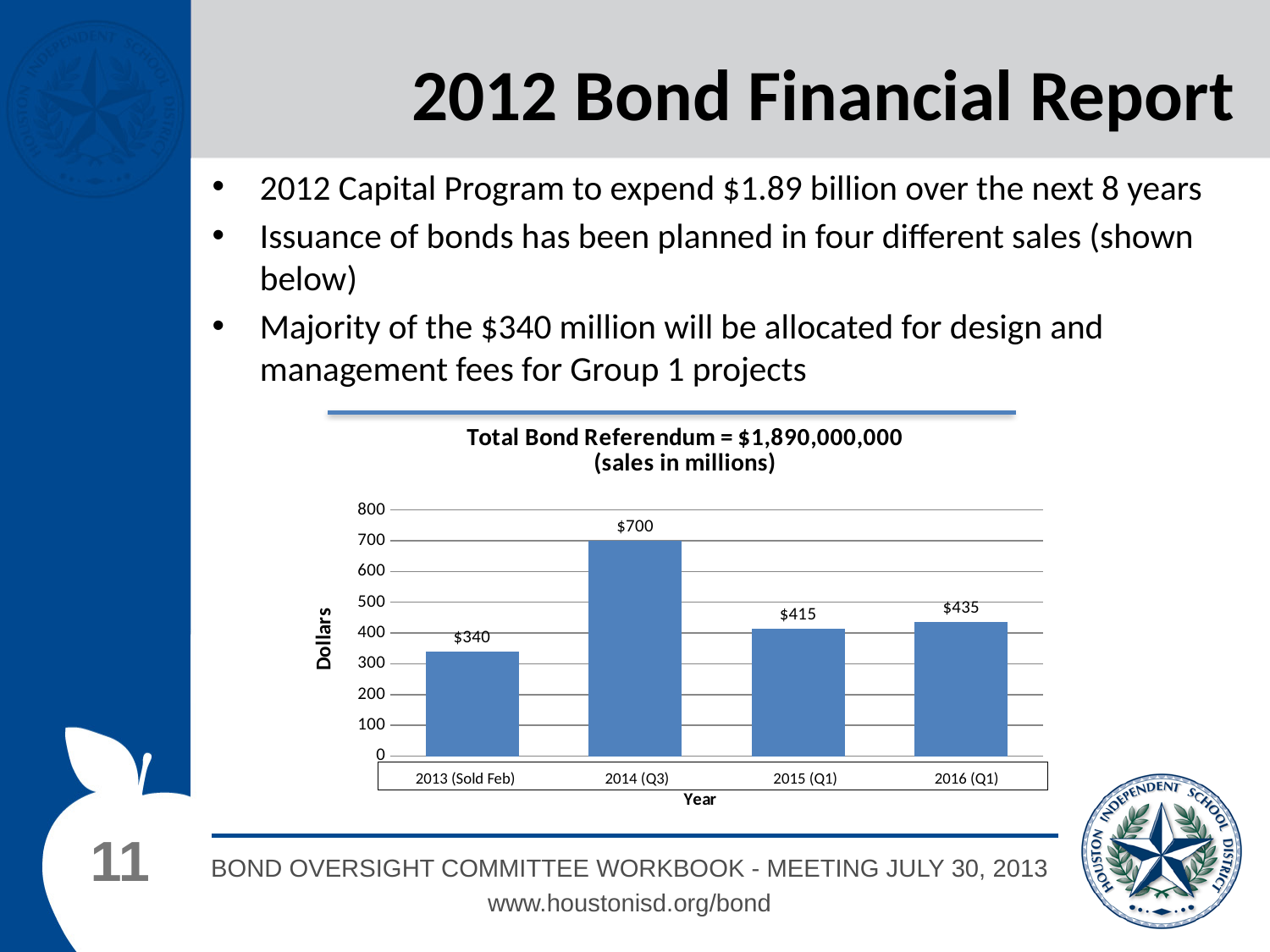
What is the difference between the values for 2014 (Q3) and 2013 (Sold Feb)? $360 What is the value for 2016 (Q1)? $435 What kind of chart is shown on the slide? Bar chart What is the value for 2015 (Q1)? $415 How many bars are shown in the chart? 4 What is the title of the chart? Total Bond Referendum = $1,890,000,000 (sales in millions) Is the value for 2014 (Q3) greater or less than 600? greater Which year has the highest bond sale value? 2014 (Q3) What is the value for 2014 (Q3)? $700 Which year has the lowest bond sale value? 2013 (Sold Feb) What is the value for 2013 (Sold Feb)? $340 Which is larger, the value for 2015 (Q1) or 2016 (Q1)? 2016 (Q1)